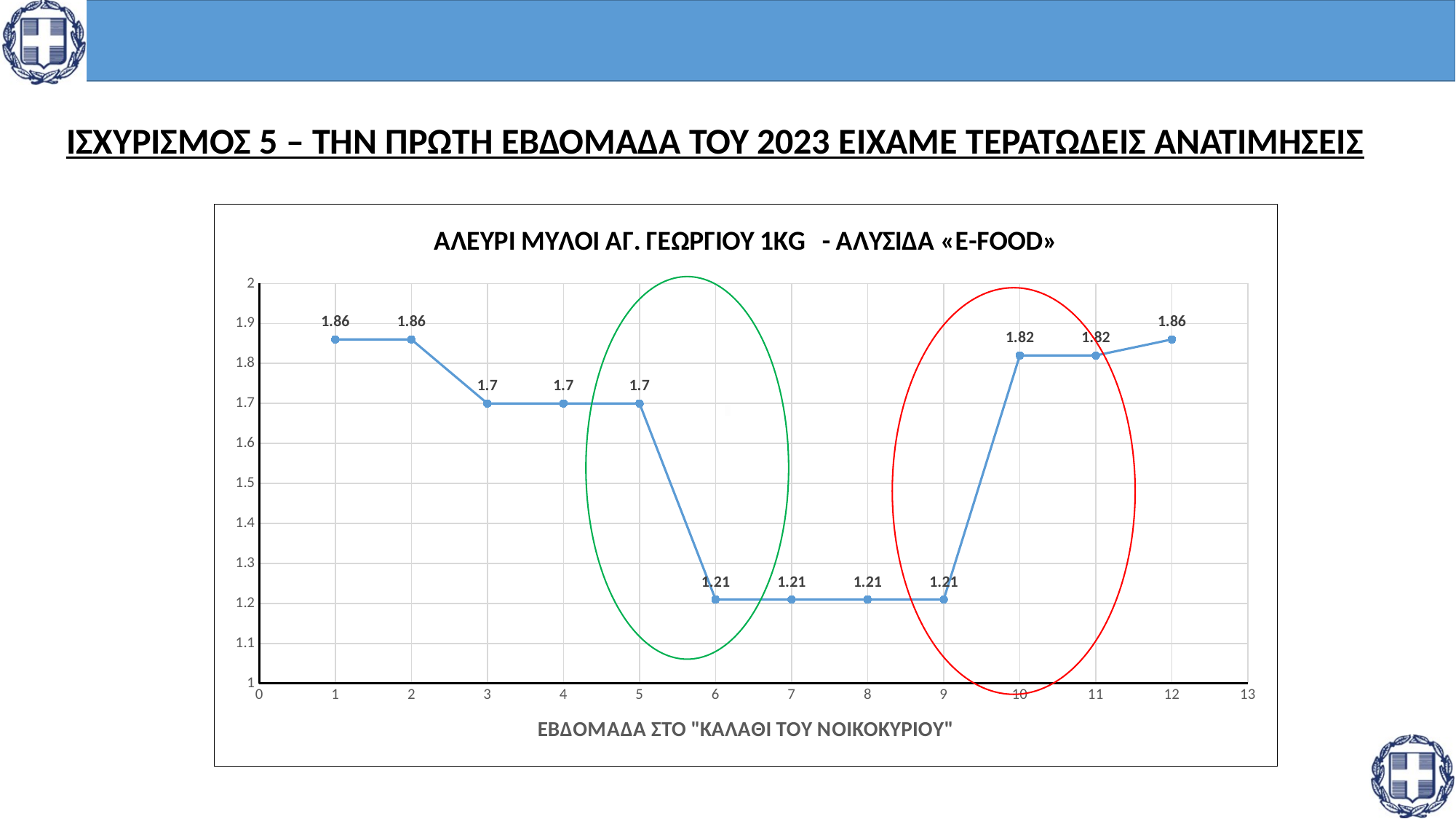
Which is larger, the value at week 3 or the value at week 10? week 10 What is the value at week 12? 1.86 What kind of chart is shown on the slide? line chart What is the difference between the value at week 12 and the value at week 11? 0.04 Is the value at week 8 greater or less than 1.5? less Do the values rise or fall from week 5 to week 6? fall What is the value at week 10? 1.82 How many weeks are plotted on the chart? 12 What is the difference between the value at week 5 and the value at week 6? 0.49 What is the value at week 1? 1.86 What is the lowest value plotted on the chart? 1.21 What is the value at week 6? 1.21